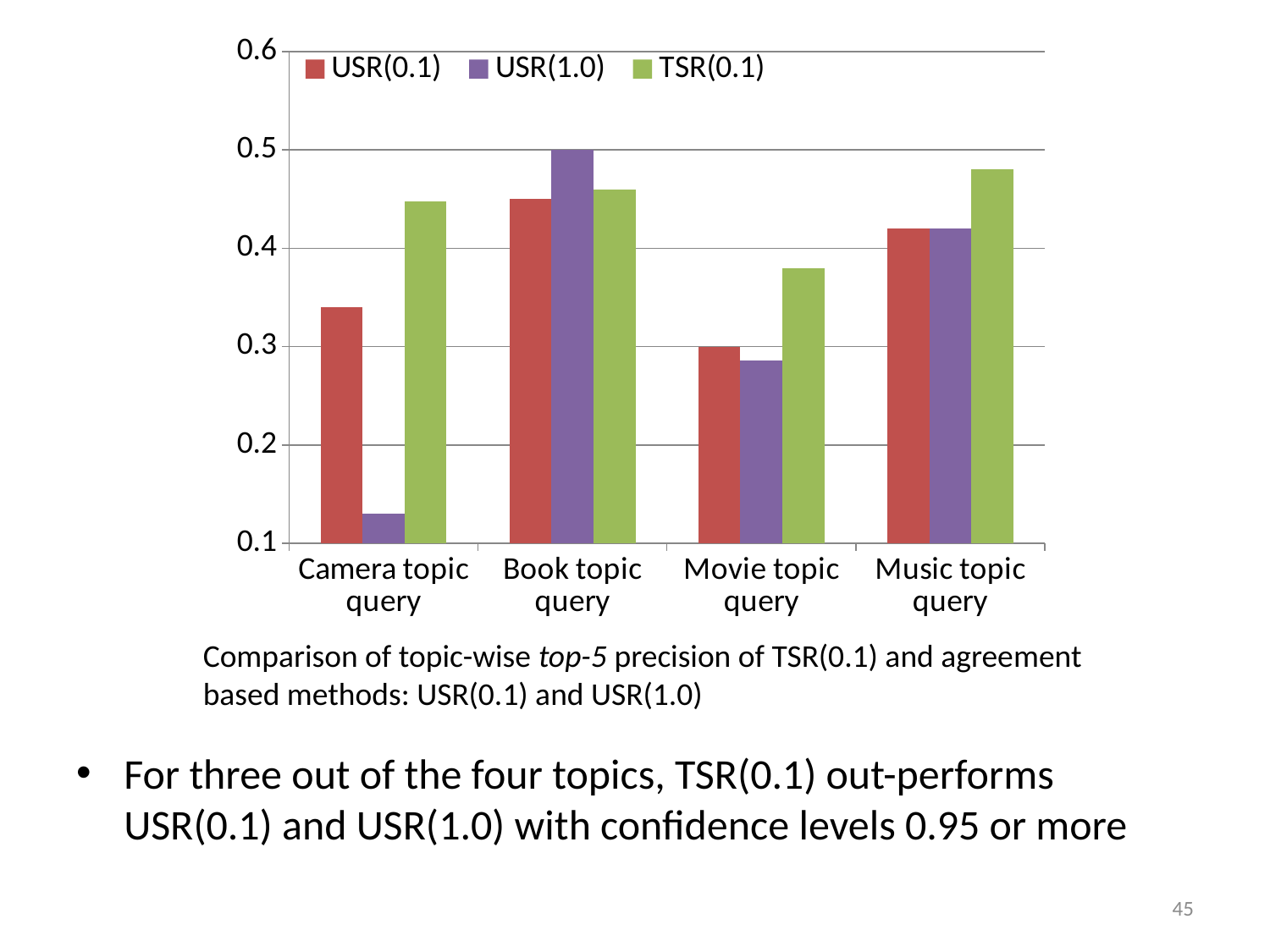
How many series does the legend list? 3 Is the value of TSR(0.1) for the Movie topic query greater or less than 0.4? less What is the value of USR(0.1) for the Movie topic query? 0.3 What kind of chart is shown on the slide? bar chart For the Camera topic query, which is larger: USR(0.1) or USR(1.0)? USR(0.1) How many topic query categories are shown on the x axis? 4 Is the value of TSR(0.1) for the Camera topic query greater or less than 0.4? greater For which topic query is the TSR(0.1) bar the highest? Music topic query Is the value of USR(1.0) for the Camera topic query greater or less than 0.2? less What is the value of USR(1.0) for the Book topic query? 0.5 Which series is shown in green in the legend? TSR(0.1) For which topic query is the USR(1.0) bar the lowest? Camera topic query